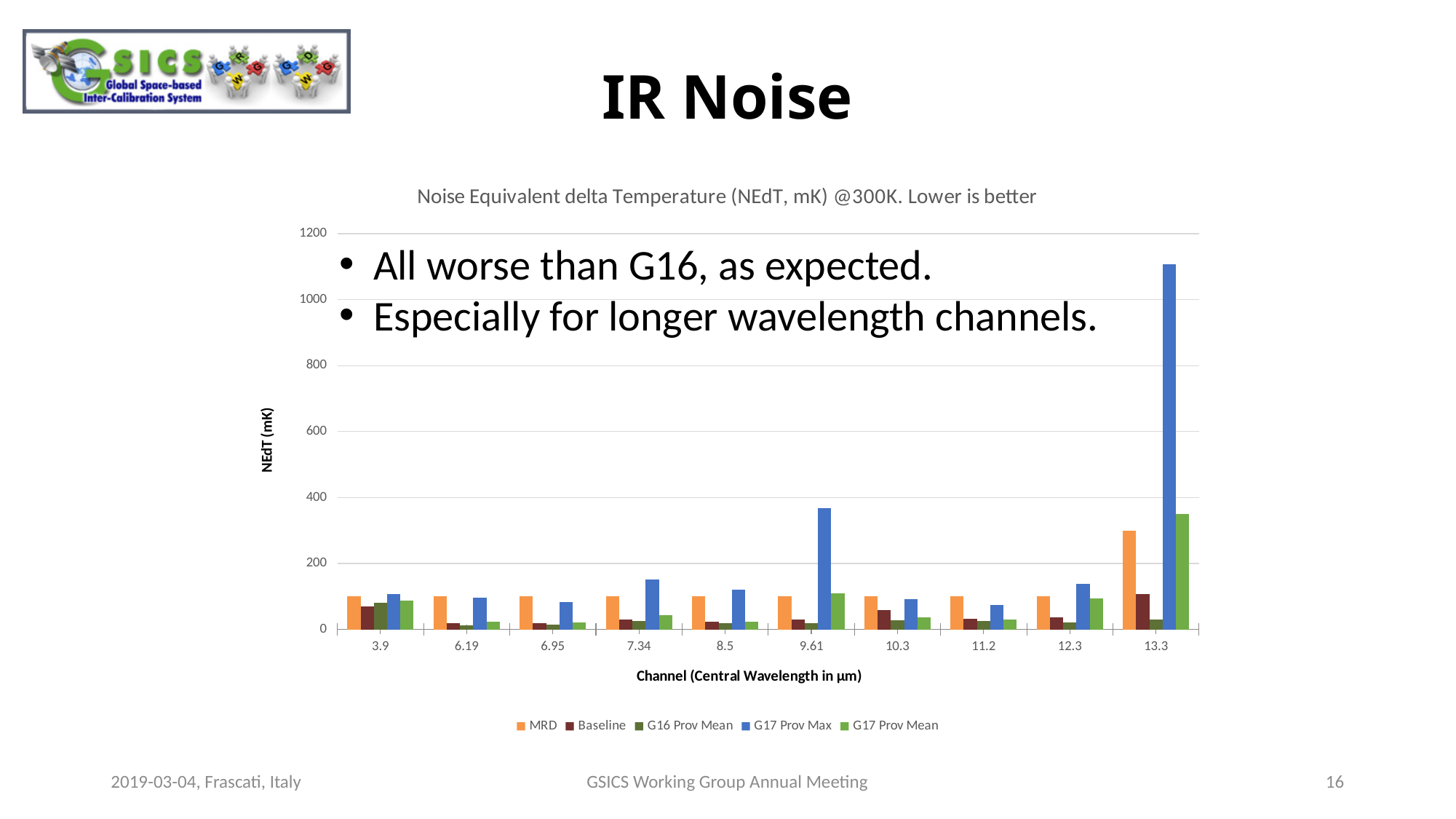
Which channel has the highest G17 Prov Mean value? 13.3 What kind of chart is shown on the slide? bar chart Is the G17 Prov Max value for channel 9.61 greater or less than 200? greater Is the G17 Prov Max value for channel 13.3 greater or less than 1000? greater How many channels (categories) are shown on the x axis of the chart? 10 What is the label of the chart's vertical axis? NEdT (mK) At channel 13.3, which is larger: the G17 Prov Max value or the MRD value? G17 Prov Max Which channel has the highest G17 Prov Max value? 13.3 Is the G17 Prov Max value for channel 7.34 greater or less than 200? less How many series does the chart legend list? 5 At channel 9.61, which is larger: the G17 Prov Max value or the G17 Prov Mean value? G17 Prov Max